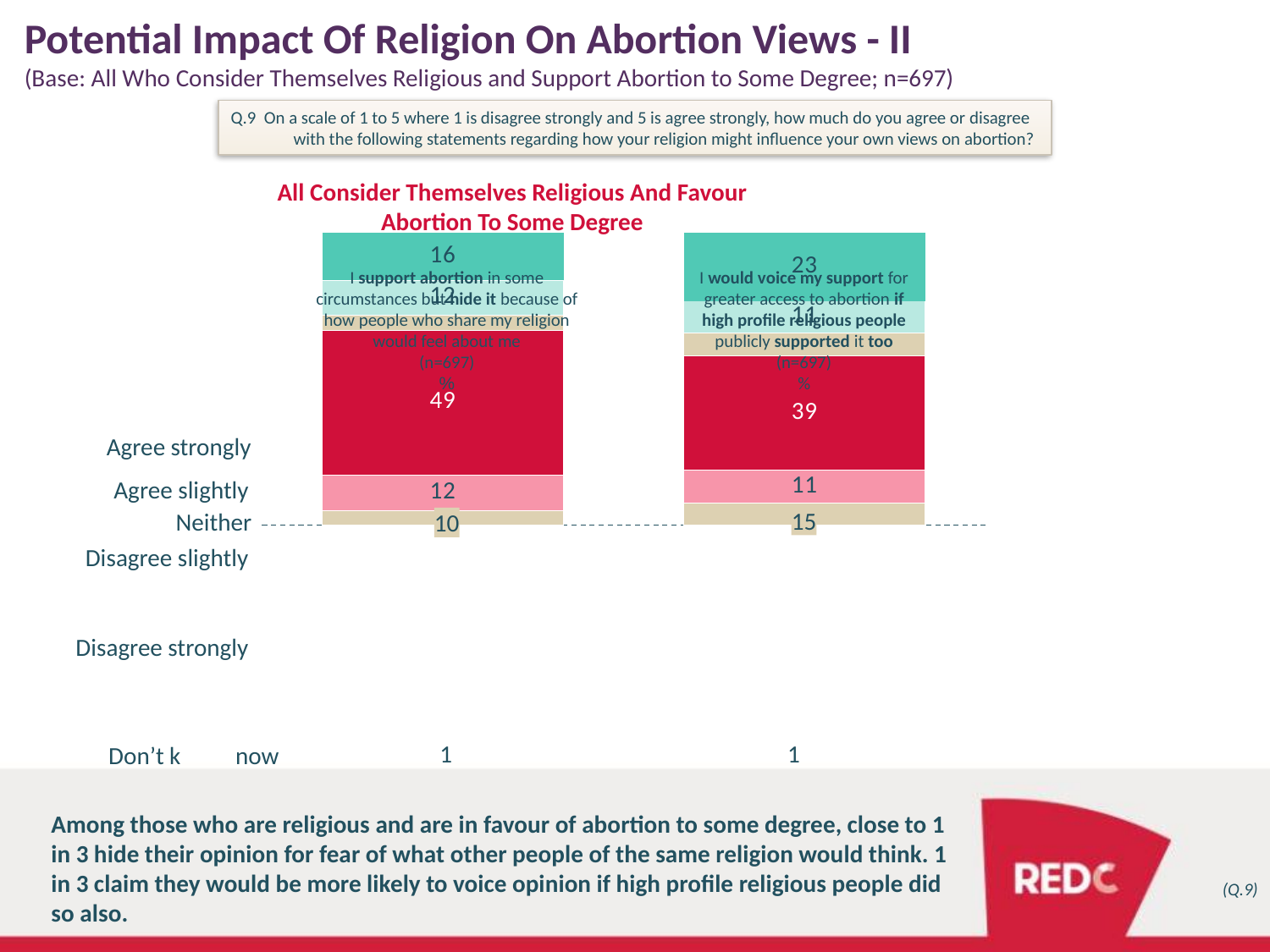
How many response categories are listed down the left side of the chart? 6 What is the title shown above the chart? All Consider Themselves Religious And Favour Abortion To Some Degree What is the value of the top (teal) segment of the right bar? 23 How many bars are plotted on the chart? 2 What is the value of the top (teal) segment of the left bar? 16 What is the 'Don't know' value for the left bar? 1 What is the value of the largest (red) segment in the right bar, 'I would voice my support for greater access to abortion'? 39 Which bar has the larger red segment, the left bar or the right bar? the left bar What kind of chart is shown on the slide? bar chart What is the difference between the red segment values of the left bar (49) and the right bar (39)? 10 What is the value of the largest (red) segment in the left bar, 'I support abortion in some circumstances but hide it'? 49 What is the total of all segments in the right bar (23, 11, 39, 11, 15, 1)? 100